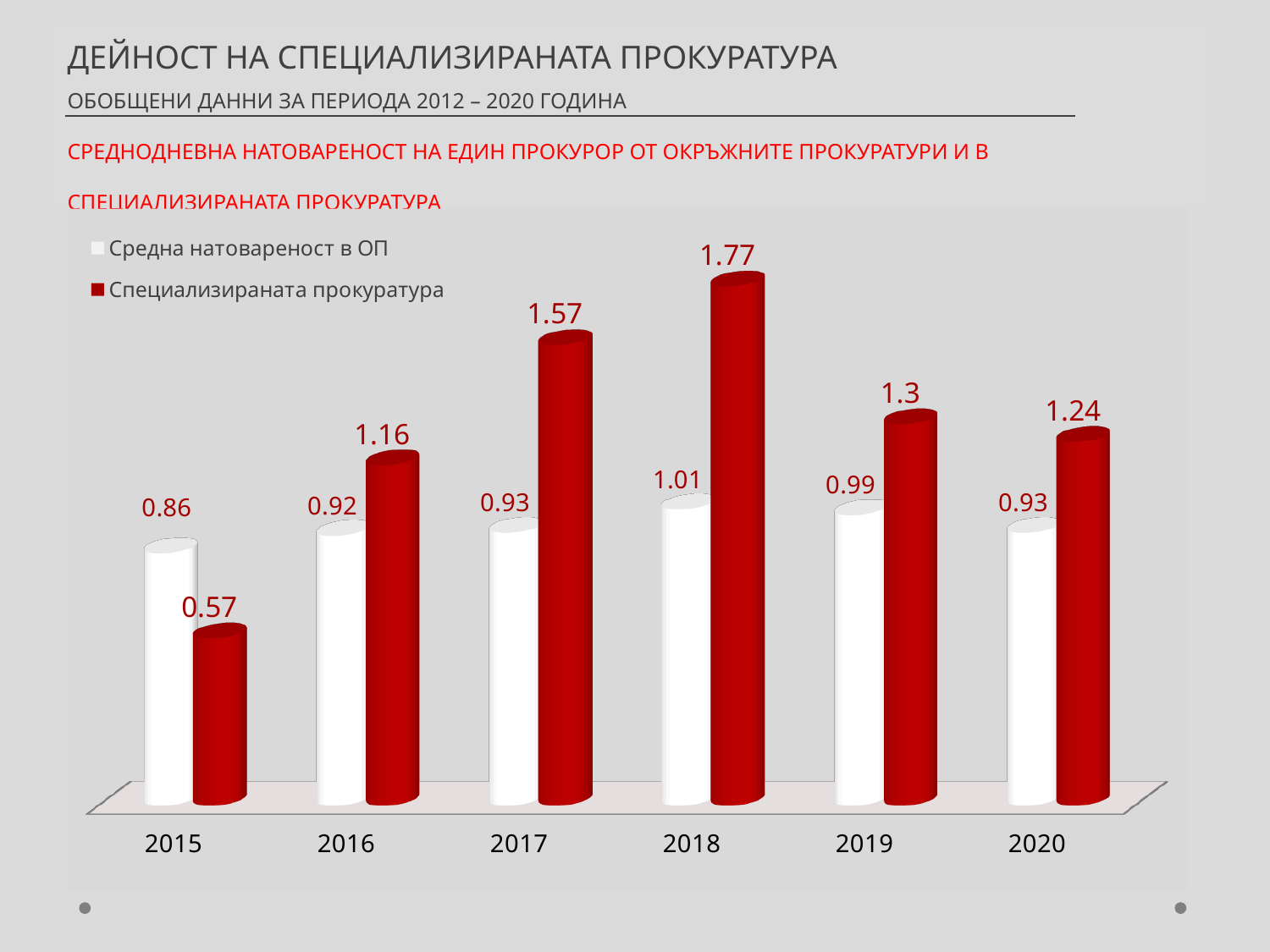
In which year is the value for Специализираната прокуратура lowest? 2015 In which year is the value for Специализираната прокуратура highest? 2018 How many series does the legend list? 2 What is the value for Специализираната прокуратура in 2015? 0.57 How many years are shown on the x axis? 6 What kind of chart is shown on the slide? Bar chart Which series has the larger value in 2015, Средна натовареност в ОП or Специализираната прокуратура? Средна натовареност в ОП What is the value for Специализираната прокуратура in 2018? 1.77 Which colour represents Специализираната прокуратура in the chart? Red What is the difference between Специализираната прокуратура and Средна натовареност в ОП in 2017? 0.64 What is the value for Средна натовареност в ОП in 2020? 0.93 What is the value for Средна натовареност в ОП in 2015? 0.86